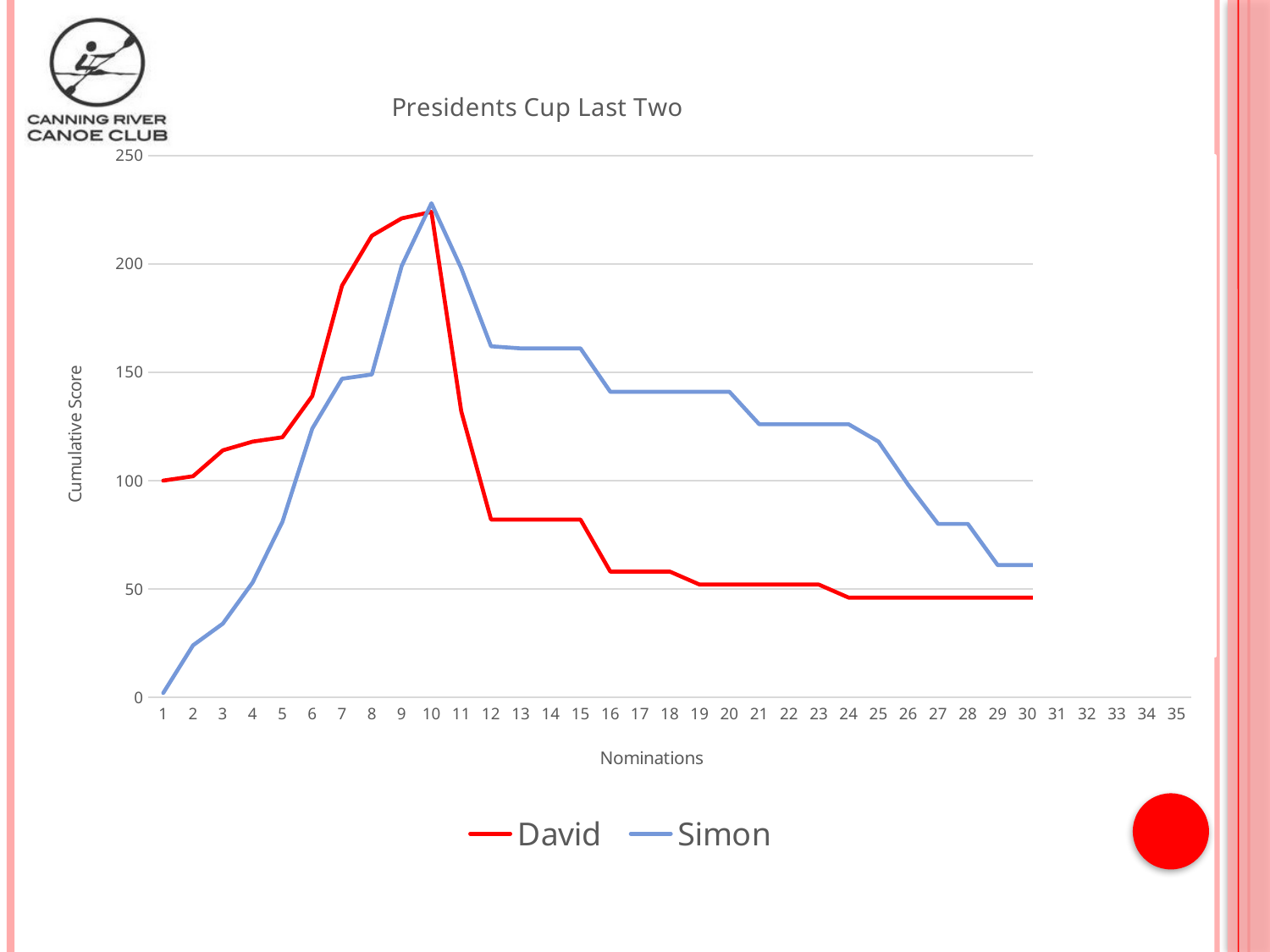
Does David's line rise or fall between nomination 10 and nomination 30? fall At nomination 5, which series has the higher value, David or Simon? David At which nomination does Simon's line reach its highest value? 10 Is Simon's value at nomination 20 greater or less than 100? greater Is David's value at nomination 8 greater or less than 200? greater What kind of chart is shown on the slide? line chart Is David's value at nomination 12 greater or less than 100? less How many series does the legend list? 2 What is the title of the chart? Presidents Cup Last Two What is the label on the vertical axis? Cumulative Score At nomination 15, which series has the higher value, David or Simon? Simon